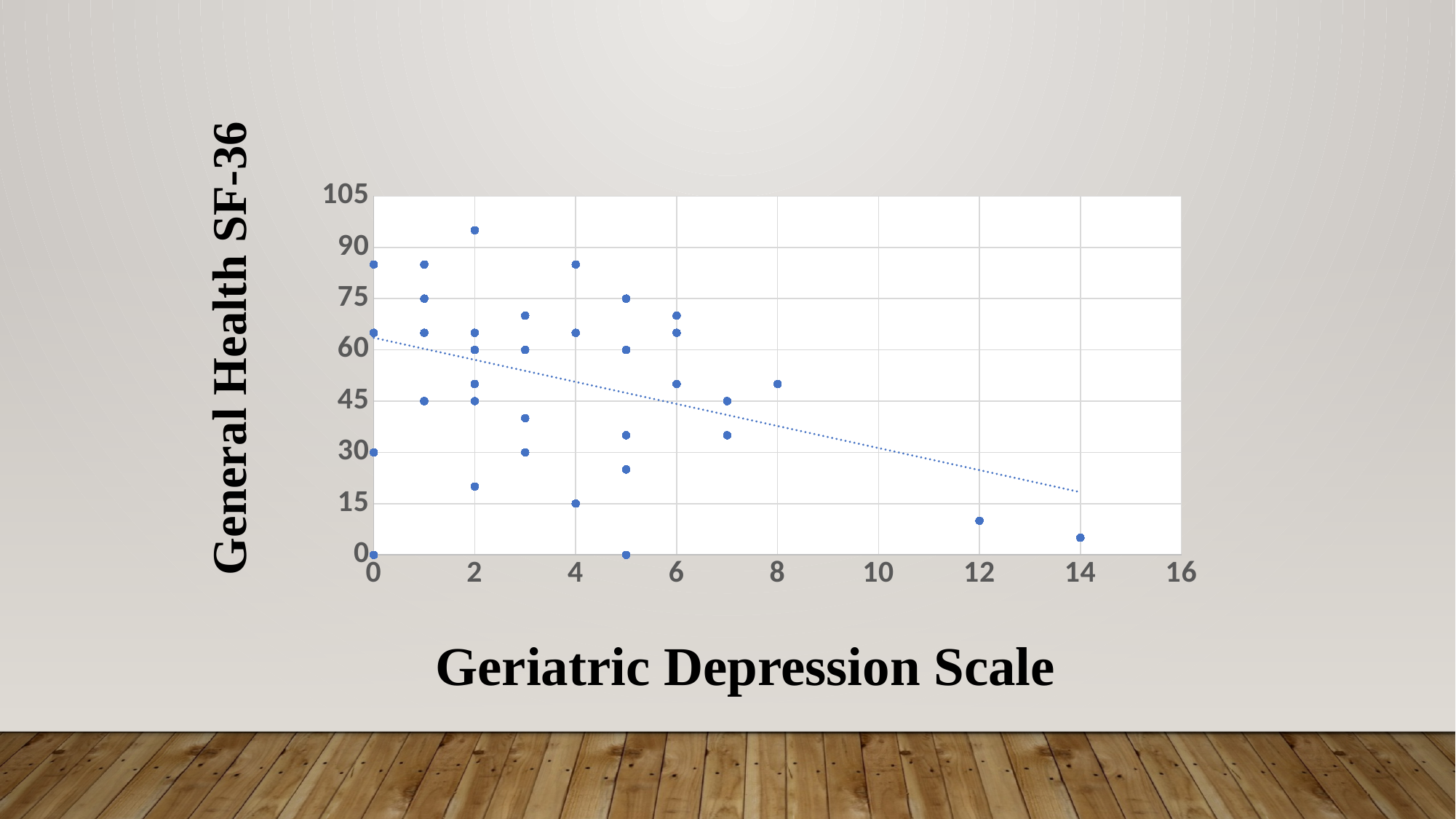
Is the highest point at Geriatric Depression Scale 2 greater or less than 90 on the General Health SF-36 axis? greater Does the dotted trend line rise or fall as the Geriatric Depression Scale increases? falls How many points have a Geriatric Depression Scale value greater than 10? 2 What kind of chart is shown on the slide? scatter plot Is the General Health SF-36 value for the point at Geriatric Depression Scale 14 greater or less than 15? less At which Geriatric Depression Scale value is the highest General Health SF-36 point plotted? 2 What is the title of the y axis? General Health SF-36 What is the lowest General Health SF-36 value plotted on the chart? 0 What is the title of the x axis? Geriatric Depression Scale Is the General Health SF-36 value for the point at Geriatric Depression Scale 8 greater or less than 45? greater Which has the larger General Health SF-36 value: the point at Geriatric Depression Scale 8 or the point at 12? the point at 8